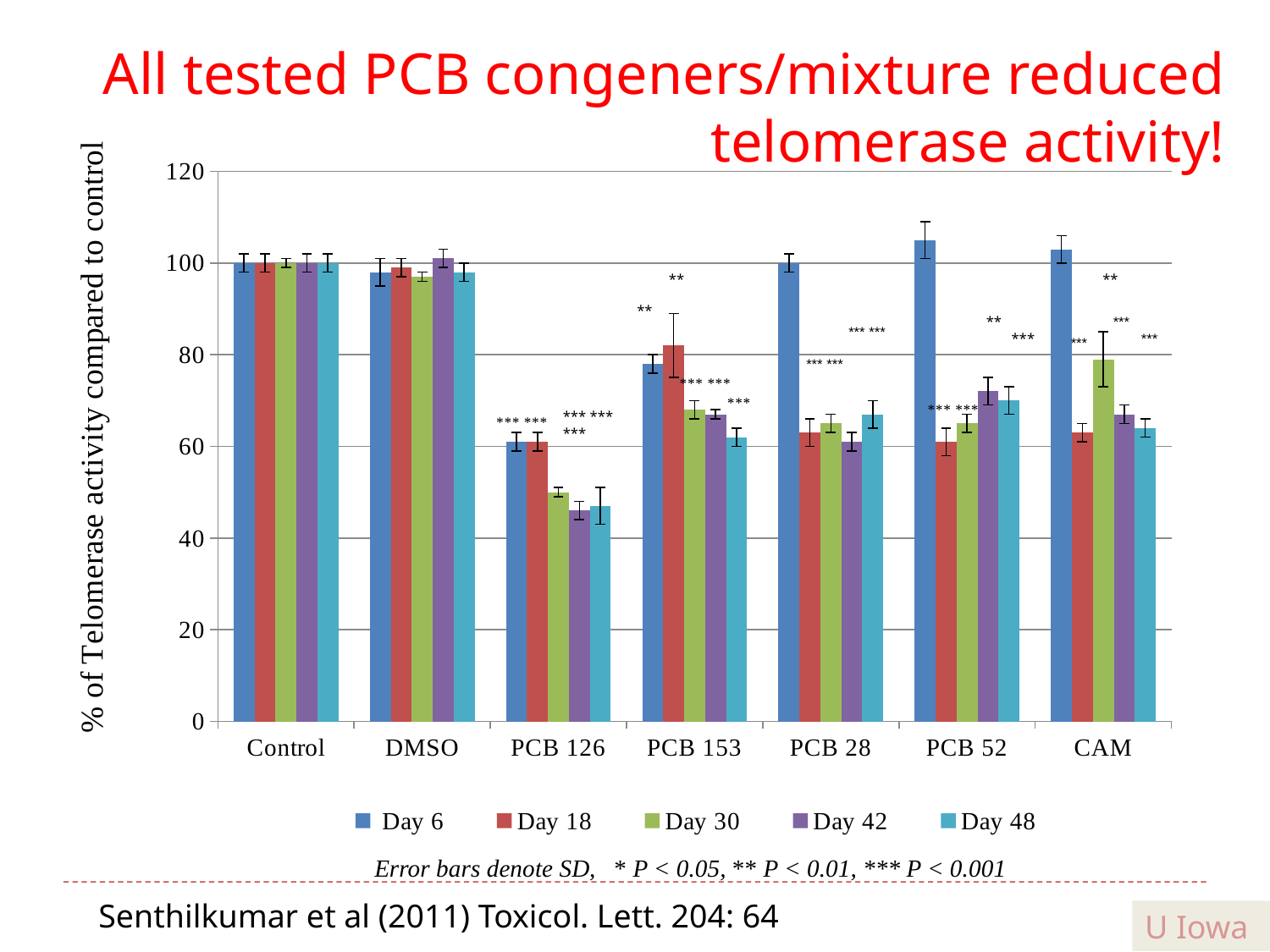
Which series is shown in red in the legend? Day 18 What kind of chart is shown on the slide? bar chart Is the Day 30 value for PCB 126 greater or less than 60? less Which is larger, the Day 18 value for PCB 153 or the Day 18 value for PCB 28? PCB 153 Is the Day 6 value for PCB 52 greater or less than 100? greater Which treatment has the lowest Day 30 value? PCB 126 How many treatment categories are shown on the x axis? 7 Is the Day 48 value for PCB 28 greater or less than 60? greater What is the label of the y axis? % of Telomerase activity compared to control What is the Day 6 value for Control? 100 How many series does the legend list? 5